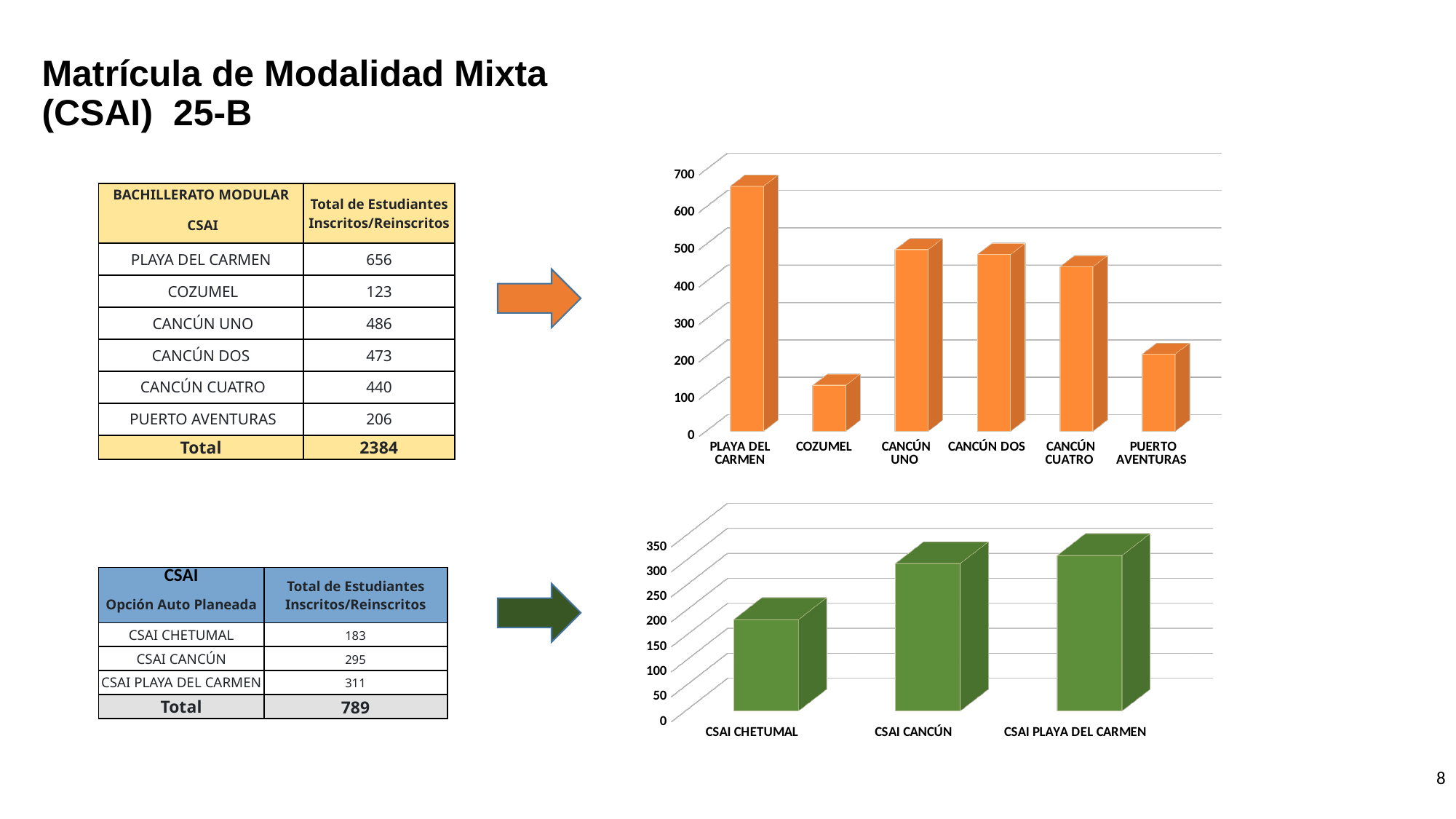
In the top chart, is the value for CANCÚN CUATRO greater or less than 400? greater In the top chart, which is larger, the value for CANCÚN UNO or the value for COZUMEL? CANCÚN UNO In the top chart, which category has the lowest value? COZUMEL In the bottom chart, which category has the lowest value? CSAI CHETUMAL What kind of chart is the top chart? bar chart In the bottom chart, is the value for CSAI CHETUMAL greater or less than 250? less What colour are the bars in the bottom chart? green How many categories are shown in the top chart? 6 In the bottom chart, which category has the highest value? CSAI PLAYA DEL CARMEN In the top chart, which category has the highest value? PLAYA DEL CARMEN In the top chart, is the value for PUERTO AVENTURAS greater or less than 300? less How many categories are shown in the bottom chart? 3